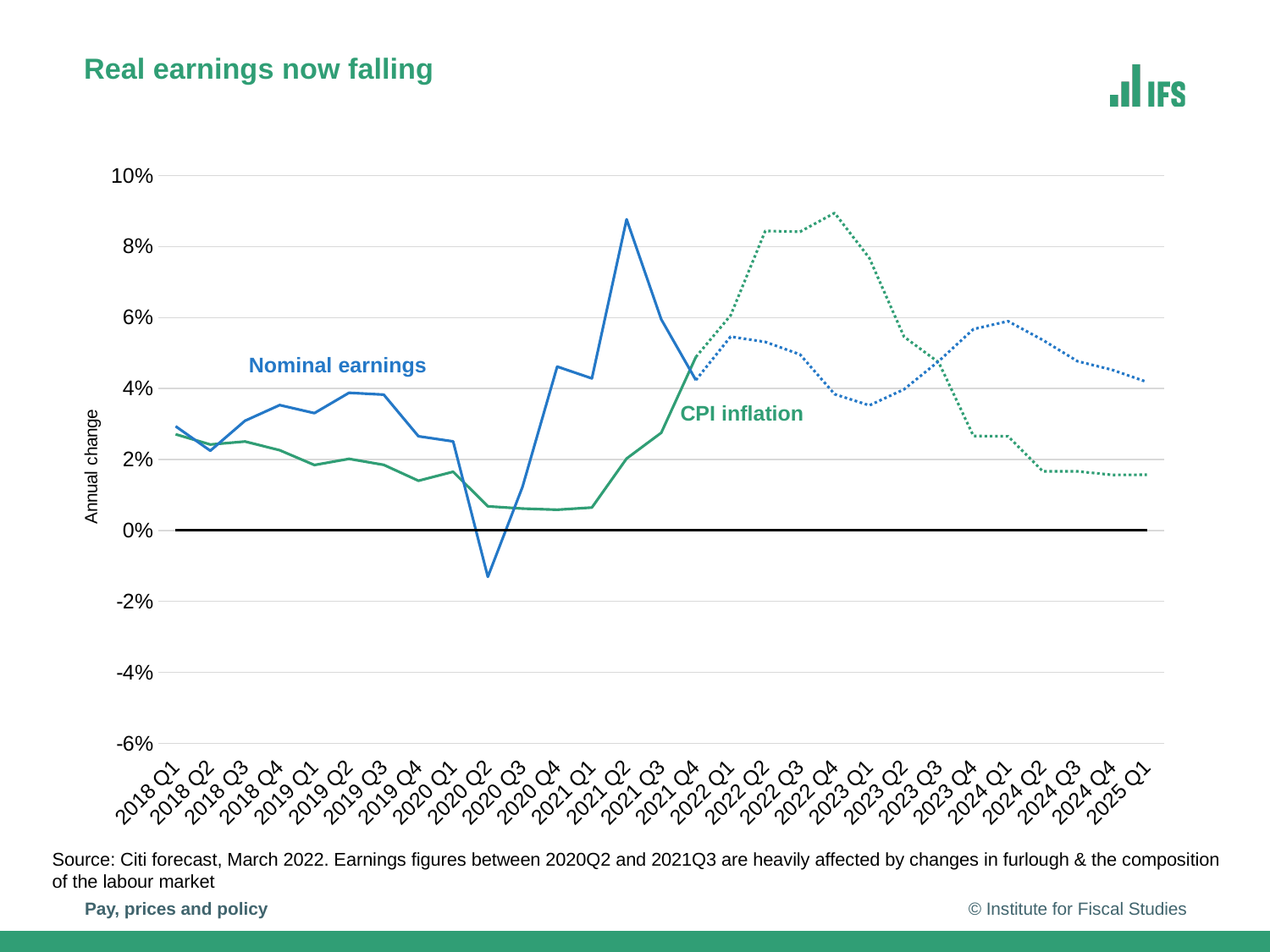
In which quarter does Nominal earnings reach its highest value? 2021 Q2 What is the title of the slide? Real earnings now falling Is the value for Nominal earnings in 2021 Q2 greater or less than 8%? greater How many quarters are shown along the x axis? 29 What type of chart is shown on the slide? Line chart Does CPI inflation rise or fall between 2022 Q4 and 2025 Q1? Fall Is the value for Nominal earnings in 2020 Q2 greater or less than 0%? less In which quarter does Nominal earnings reach its lowest value? 2020 Q2 Is the value for CPI inflation in 2025 Q1 greater or less than 2%? less In which quarter does CPI inflation reach its highest value? 2022 Q4 How many series are plotted on the chart? 2 In 2022 Q4, which series is higher, Nominal earnings or CPI inflation? CPI inflation